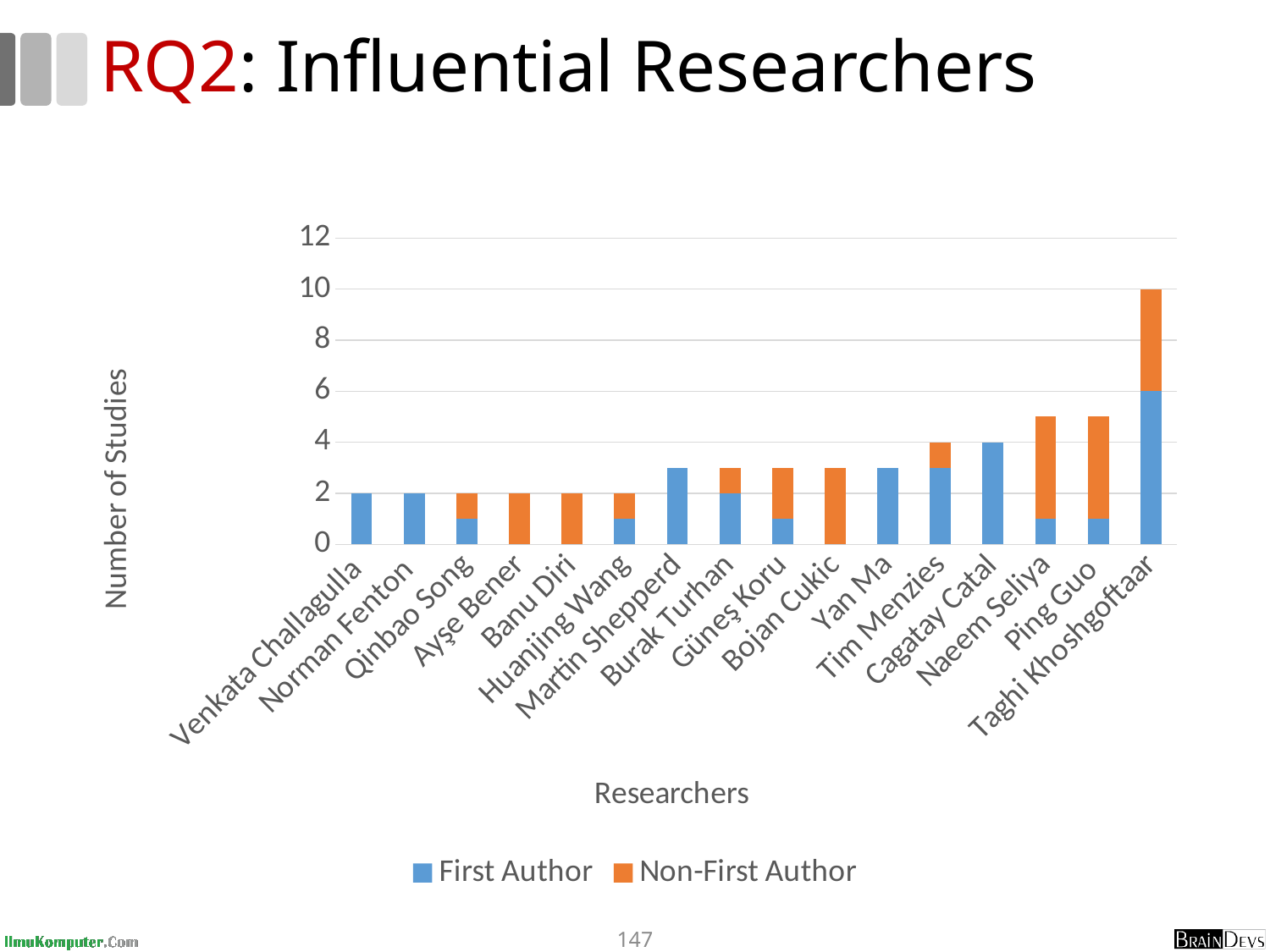
What is the total number of studies for Cagatay Catal? 4 What is the total number of studies for Taghi Khoshgoftaar? 10 Which researcher has the highest total number of studies? Taghi Khoshgoftaar What is the First Author value for Taghi Khoshgoftaar? 6 Is the total value for Yan Ma greater or less than 4? less Do the total values generally rise or fall from left to right along the x axis? rise What kind of chart is shown on the slide? bar chart How many series does the legend list? 2 What is the title of the y axis? Number of Studies Is the total value for Naeem Seliya greater or less than 4? greater What is the difference between the total studies of Taghi Khoshgoftaar and Cagatay Catal? 6 How many researchers are shown on the x axis? 16